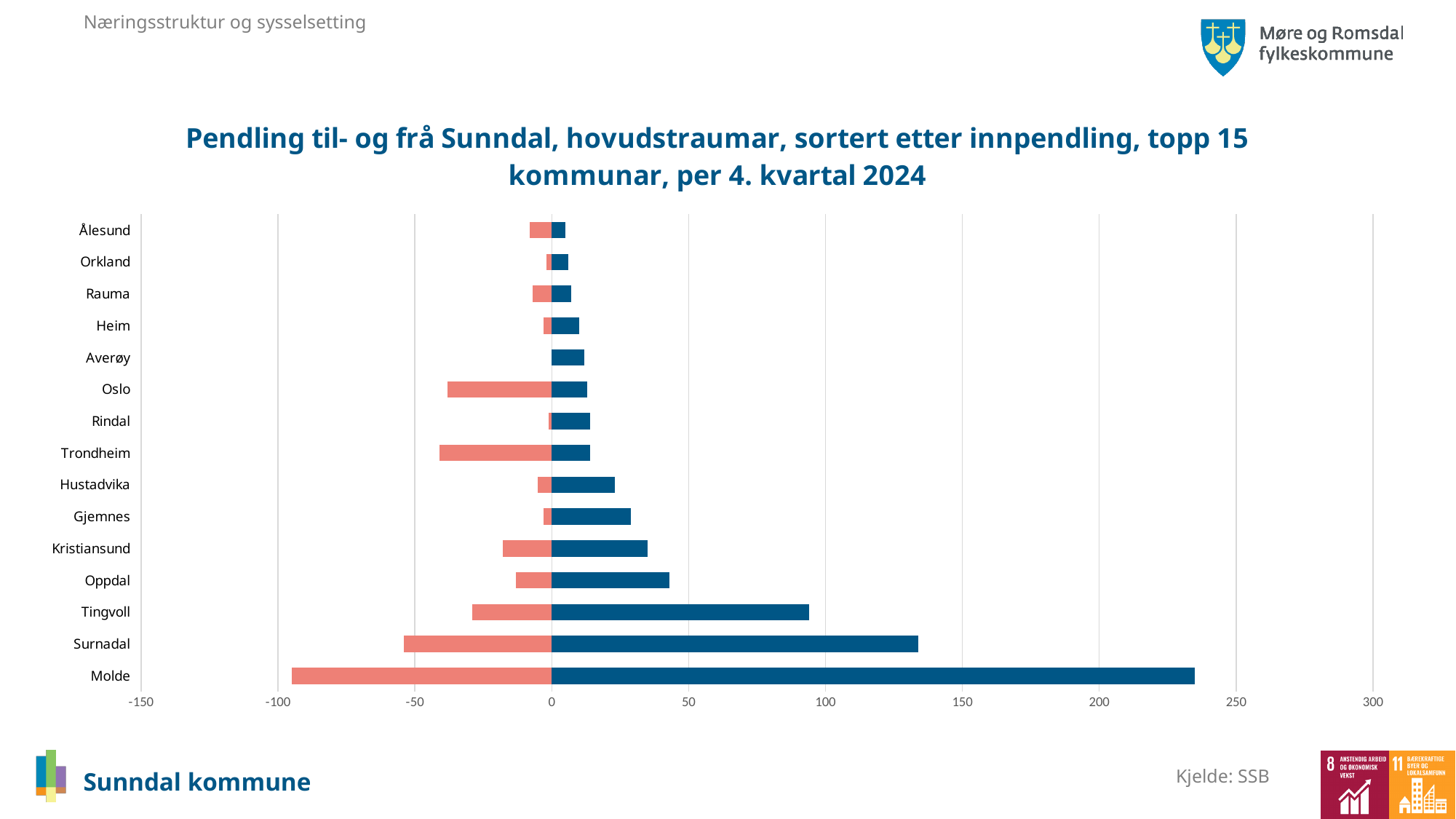
Which has the larger blue bar, Surnadal or Tingvoll? Surnadal Is the blue bar value for Surnadal greater or less than 100? greater Which municipality has the longest red (negative) bar? Molde Is the blue bar value for Oppdal greater or less than 50? less Which municipality has the longest blue (positive) bar? Molde Which has the longer red bar, Molde or Surnadal? Molde What kind of chart is shown on the slide? bar chart How many municipalities are listed on the vertical axis of the chart? 15 Is the red bar value for Trondheim greater or less than -50? greater What is the title of the chart? Pendling til- og frå Sunndal, hovudstraumar, sortert etter innpendling, topp 15 kommunar, per 4. kvartal 2024 Going from the top of the chart (Ålesund) to the bottom (Molde), do the blue bars get longer or shorter? longer